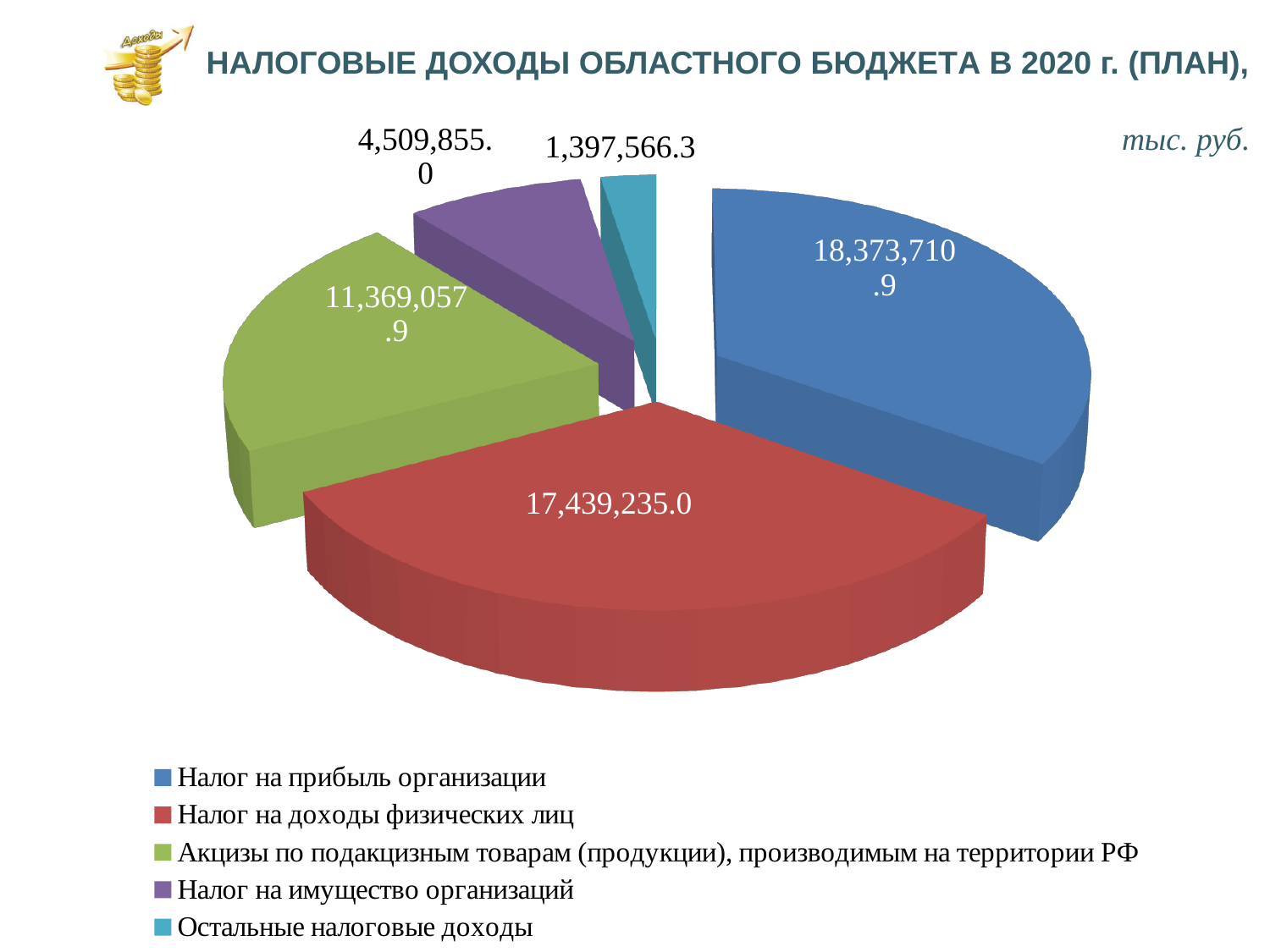
What unit is stated for the values on the chart? тыс. руб. Which category has the smallest value? Остальные налоговые доходы What is the value for Налог на имущество организаций? 4,509,855.0 What is the value for Акцизы по подакцизным товарам (продукции), производимым на территории РФ? 11,369,057.9 What is the value for Налог на доходы физических лиц? 17,439,235.0 Which category has the largest value? Налог на прибыль организации How many slices does the pie chart have? 5 What is the value for Налог на прибыль организации? 18,373,710.9 What type of chart is shown on the slide? Pie chart What is the value for Остальные налоговые доходы? 1,397,566.3 What is the difference between the values for Налог на прибыль организации and Налог на доходы физических лиц? 934,475.9 Which is larger: Налог на имущество организаций or Остальные налоговые доходы? Налог на имущество организаций